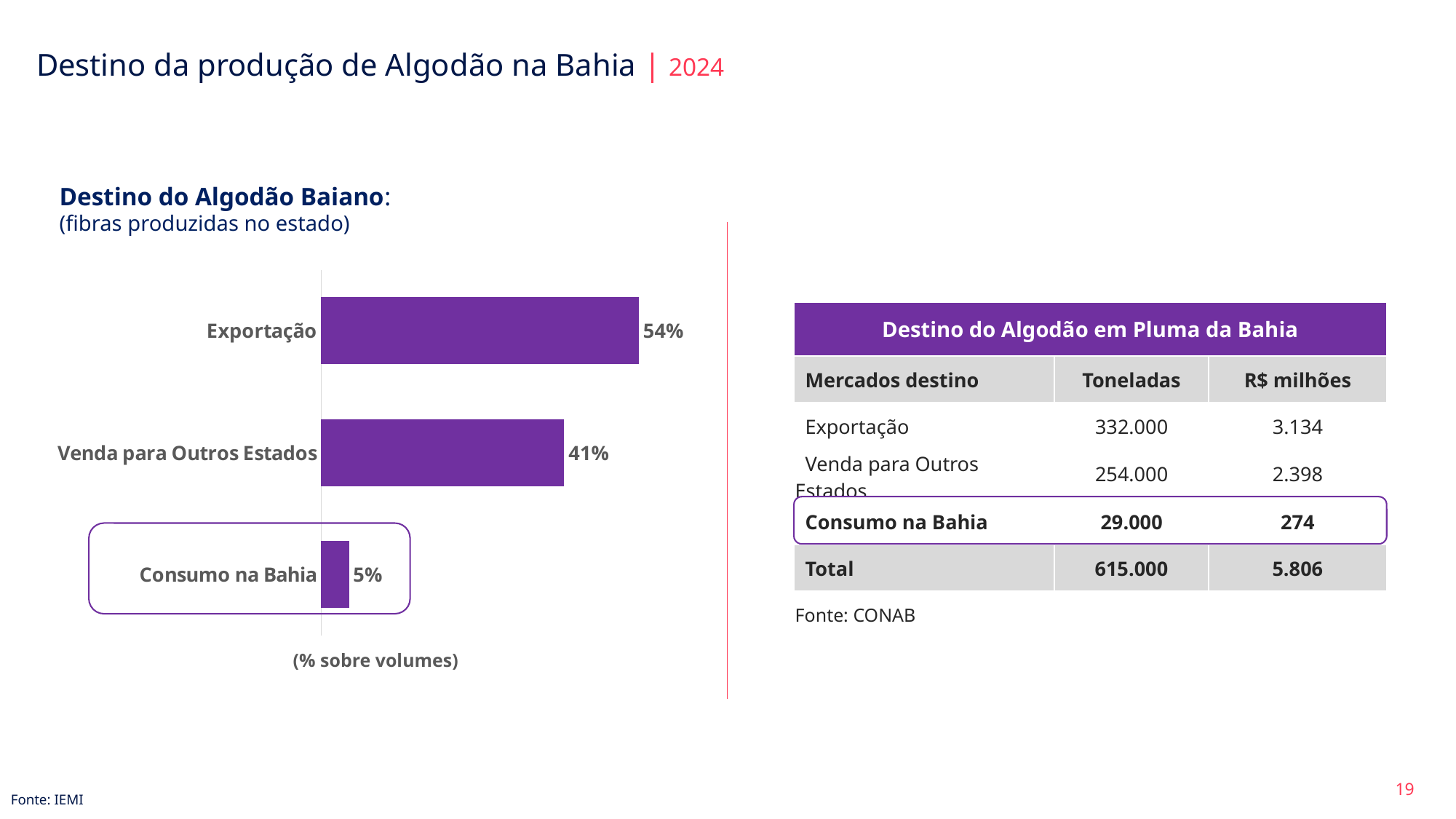
What is the value for Consumo na Bahia in the bar chart? 5% Which category has the highest value in the bar chart? Exportação Which is larger in the bar chart, Exportação or Consumo na Bahia? Exportação What is the title of the chart on the slide? Destino do Algodão Baiano: (fibras produzidas no estado) How many categories are shown in the bar chart? 3 What is the difference between the values for Exportação and Venda para Outros Estados in the bar chart? 13% What kind of chart is shown on the slide? Bar chart What unit label is shown below the bar chart? (% sobre volumes) Which category has the lowest value in the bar chart? Consumo na Bahia What is the value for Exportação in the bar chart? 54% What is the value for Venda para Outros Estados in the bar chart? 41% What is the difference between the values for Venda para Outros Estados and Consumo na Bahia in the bar chart? 36%